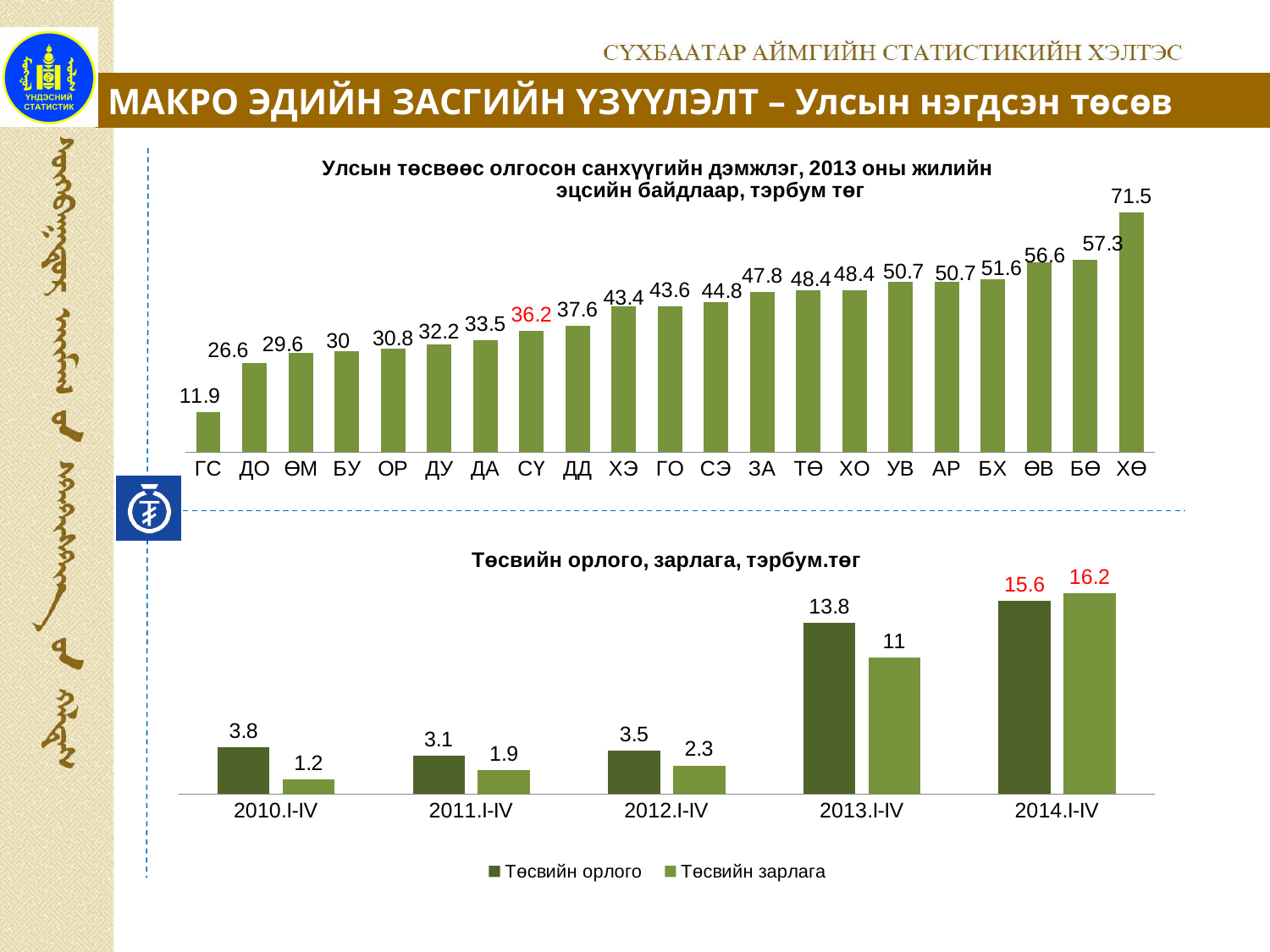
What type of chart is the bottom chart (Төсвийн орлого, зарлага)? bar chart In the top chart (Улсын төсвөөс олгосон санхүүгийн дэмжлэг), which category has the lowest value? ГС In the bottom chart (Төсвийн орлого, зарлага), which is larger for 2014.I-IV: Төсвийн орлого or Төсвийн зарлага? Төсвийн зарлага In the bottom chart (Төсвийн орлого, зарлага), how many series does the legend list? 2 In the top chart (Улсын төсвөөс олгосон санхүүгийн дэмжлэг), how many categories are shown? 21 In the top chart (Улсын төсвөөс олгосон санхүүгийн дэмжлэг), what is the difference between the values for ХӨ and БӨ? 14.2 In the bottom chart (Төсвийн орлого, зарлага), what is the value of Төсвийн орлого for 2014.I-IV? 15.6 In the top chart (Улсын төсвөөс олгосон санхүүгийн дэмжлэг), do the values rise or fall from left to right? rise In the bottom chart (Төсвийн орлого, зарлага), what is the value of Төсвийн зарлага for 2013.I-IV? 11 In the top chart (Улсын төсвөөс олгосон санхүүгийн дэмжлэг), which category has the highest value? ХӨ In the top chart (Улсын төсвөөс олгосон санхүүгийн дэмжлэг), what is the value for СҮ? 36.2 In the bottom chart (Төсвийн орлого, зарлага), what is the difference between Төсвийн орлого and Төсвийн зарлага for 2010.I-IV? 2.6